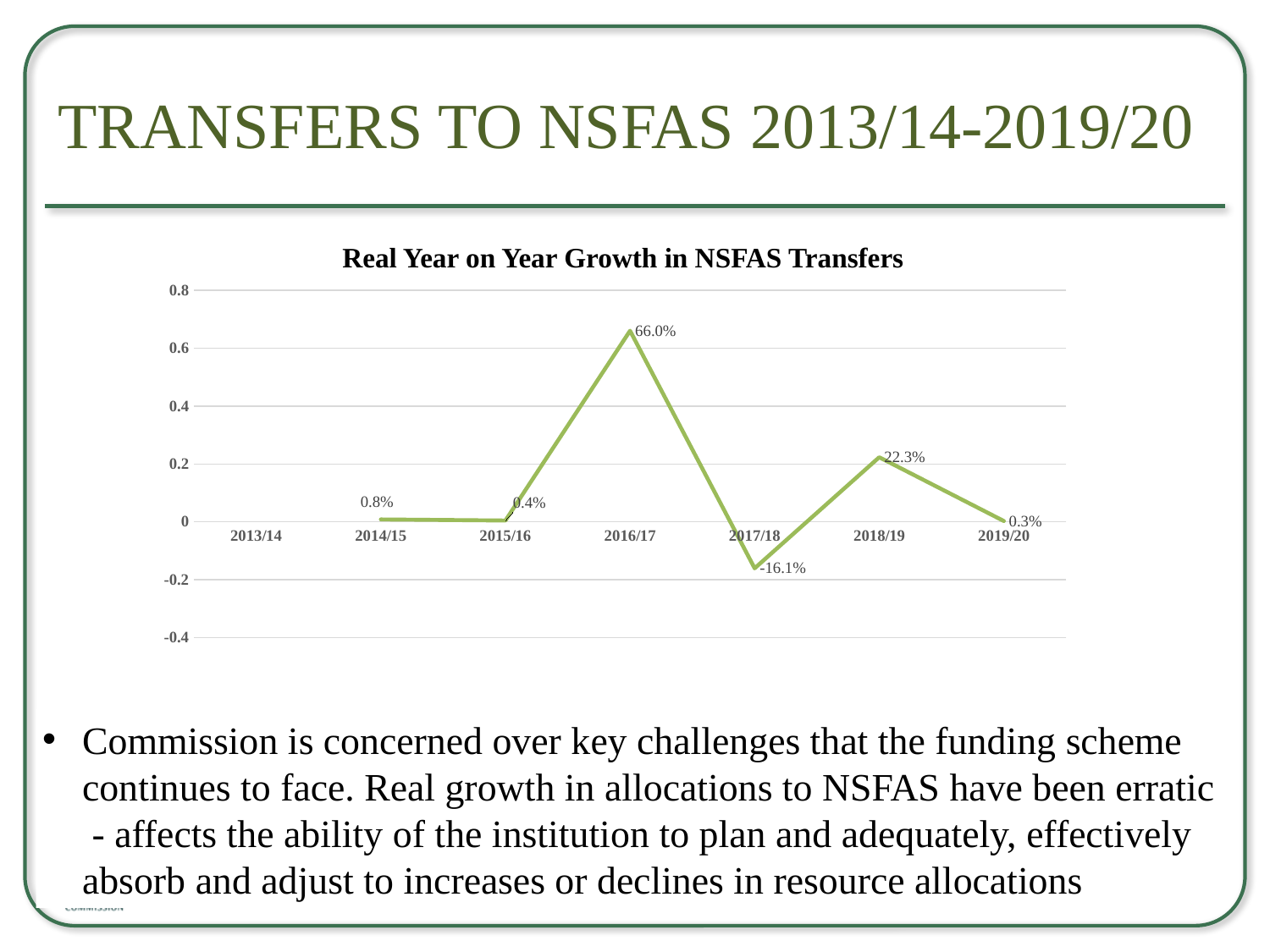
Which is larger, the growth in 2014/15 or the growth in 2018/19? 2018/19 Which year has the lowest real year on year growth in NSFAS transfers? 2017/18 What is the title of the chart? Real Year on Year Growth in NSFAS Transfers What is the real year on year growth in NSFAS transfers for 2018/19? 22.3% What kind of chart is shown on the slide? Line chart How many year labels appear on the x axis of the chart? 7 Does the growth rise or fall from 2016/17 to 2017/18? Fall What is the real year on year growth in NSFAS transfers for 2017/18? -16.1% What is the real year on year growth in NSFAS transfers for 2016/17? 66.0% What is the real year on year growth in NSFAS transfers for 2019/20? 0.3% What is the difference between the growth in 2016/17 and the growth in 2018/19? 43.7 percentage points Which year has the highest real year on year growth in NSFAS transfers? 2016/17